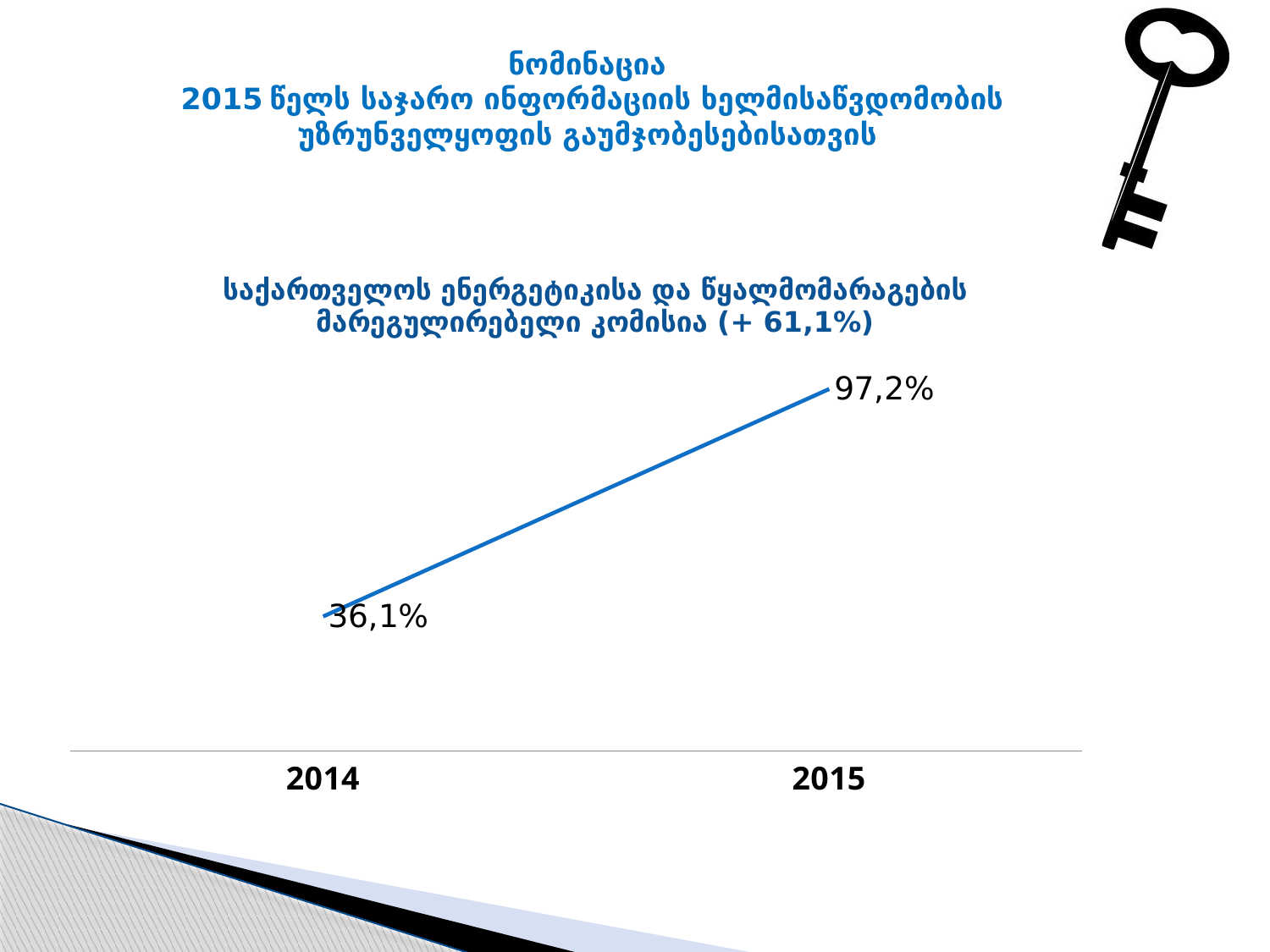
Which years are shown on the x axis? 2014 and 2015 Does the value rise or fall from 2014 to 2015? Rise How many data points are plotted on the chart? 2 Which year has the lower value? 2014 What percentage change is shown in parentheses in the chart title? + 61,1% What colour is the line on the chart? Blue What is the value for 2015? 97,2% By how much did the value increase from 2014 to 2015? 61,1% What kind of chart is shown on the slide? Line chart What is the value for 2014? 36,1% Which year has the higher value? 2015 Is the value for 2015 larger than the value for 2014? Yes